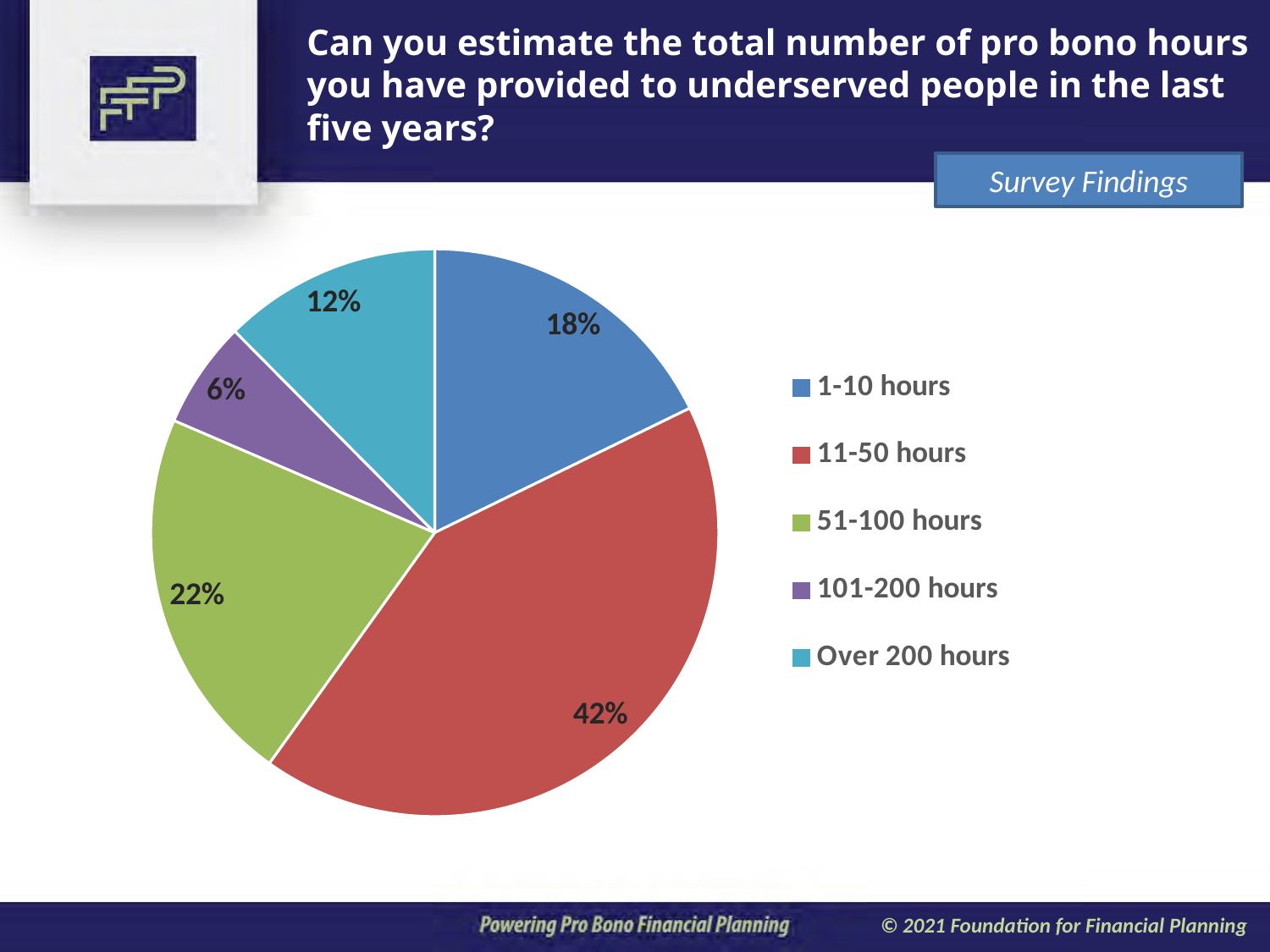
How many categories does the pie chart show? 5 What share of respondents reported 101-200 hours? 6% What share of respondents reported Over 200 hours? 12% What share of respondents reported 1-10 hours? 18% What share of respondents reported 11-50 hours? 42% What is the difference in percentage points between the 11-50 hours slice and the 51-100 hours slice? 20 What kind of chart is shown on the slide? pie chart Which is larger, the share for 1-10 hours or the share for Over 200 hours? 1-10 hours What share of respondents reported 51-100 hours? 22% Which category has the smallest share of the pie? 101-200 hours What colour is the slice for 51-100 hours? green Which category has the largest share of the pie? 11-50 hours